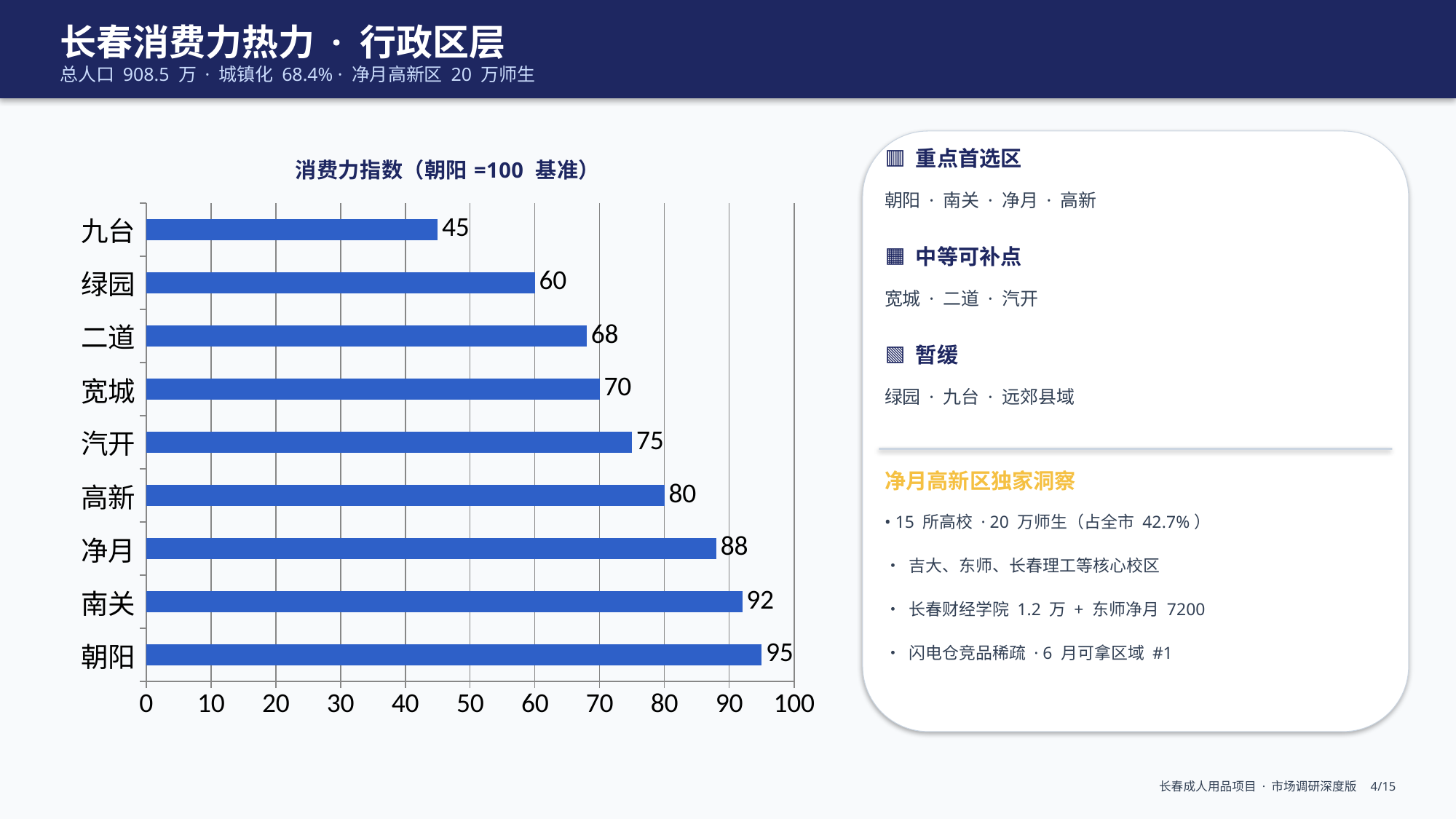
What is the difference between the values for 朝阳 and 九台? 50 What is the value shown for 九台 in the chart? 45 Which district has the highest consumption power index? 朝阳 Which district has the lowest consumption power index? 九台 What kind of chart is shown on the slide? bar chart What is the consumption power index value for 净月? 88 What is the value shown for 二道? 68 What is the difference between the values for 南关 and 高新? 12 What is the title of the chart? 消费力指数（朝阳 =100 基准） How many districts are shown in the chart? 9 Is the value for 汽开 greater or less than 70? greater Which has a higher consumption power index, 宽城 or 绿园? 宽城